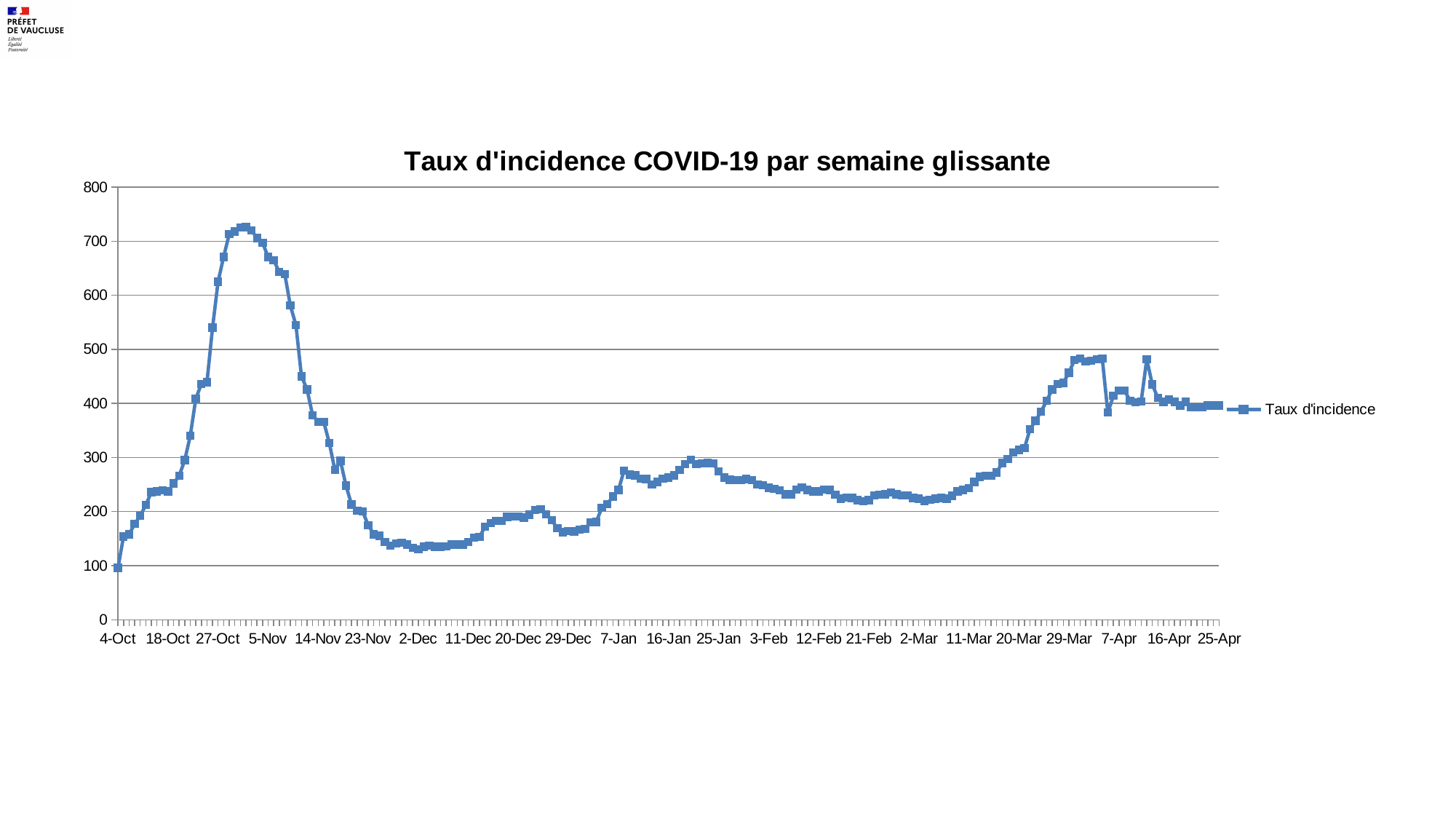
What is the name of the series shown in the legend? Taux d'incidence Which labelled date on the x axis has the lowest value? 4-Oct Which is larger, the value for 5-Nov or the value for 25-Apr? 5-Nov Is the value for 2-Dec greater or less than 200? less Do the values rise or fall between 5-Nov and 2-Dec? fall How many series does the legend list? 1 Is the value for 25-Apr greater or less than 500? less Is the value for 5-Nov greater or less than 600? greater What kind of chart is shown on the slide? line chart What is the title of the chart? Taux d'incidence COVID-19 par semaine glissante